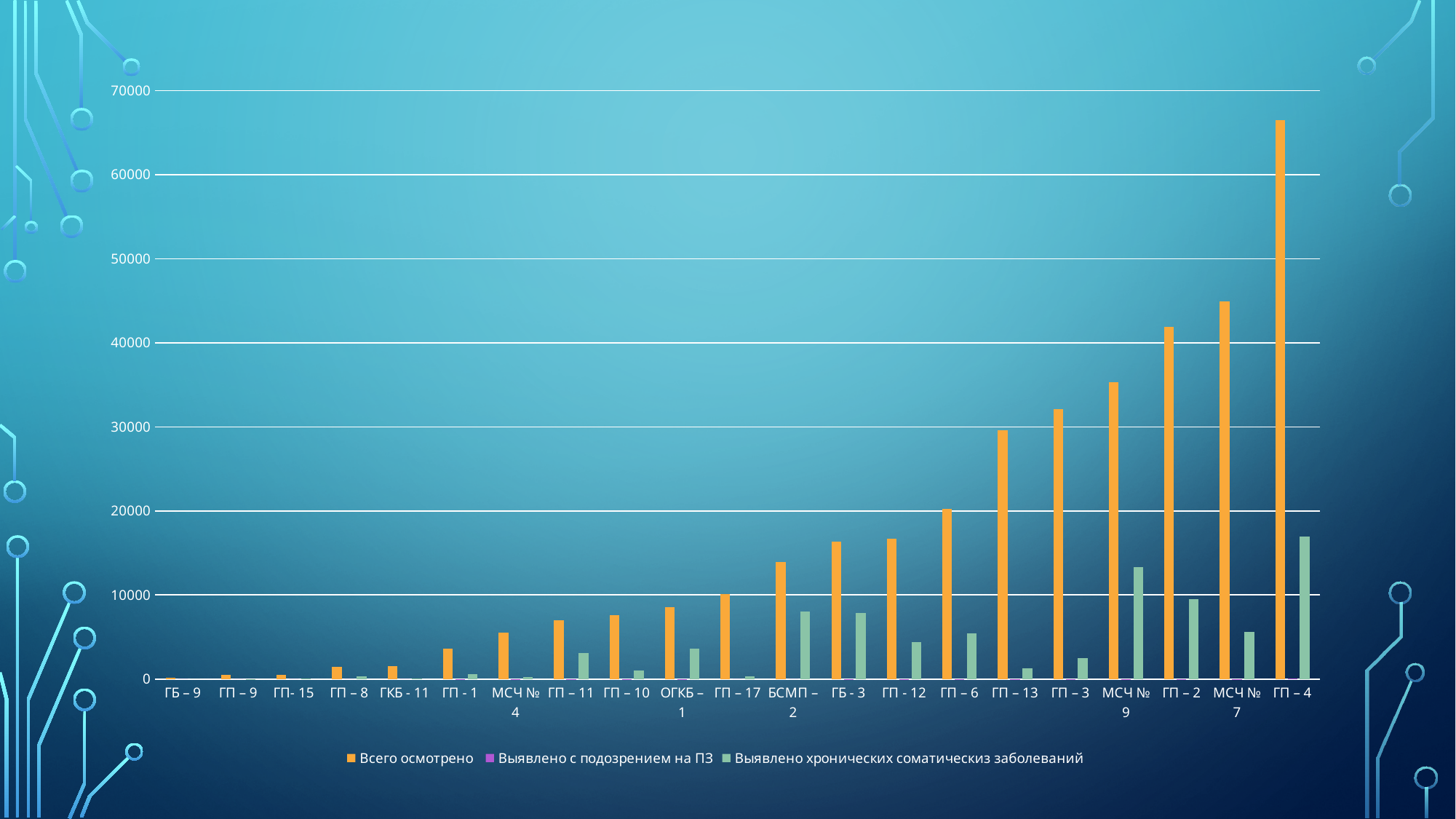
Which has the larger "Всего осмотрено" value, ГП – 2 or ГП – 3? ГП – 2 Which category has the highest value for "Выявлено хронических соматическиз заболеваний"? ГП – 4 What type of chart is shown on the slide? bar chart Do the "Всего осмотрено" values generally rise or fall from left to right along the x axis? rise Is the "Всего осмотрено" value for ГП – 4 greater or less than 60000? greater Is the "Всего осмотрено" value for ОГКБ – 1 greater or less than 10000? less How many categories are shown on the x axis? 21 Is the "Выявлено хронических соматическиз заболеваний" value for МСЧ № 9 greater or less than 10000? greater How many series does the legend list? 3 Which category has the highest value for "Всего осмотрено"? ГП – 4 Which category has the lowest value for "Всего осмотрено"? ГБ – 9